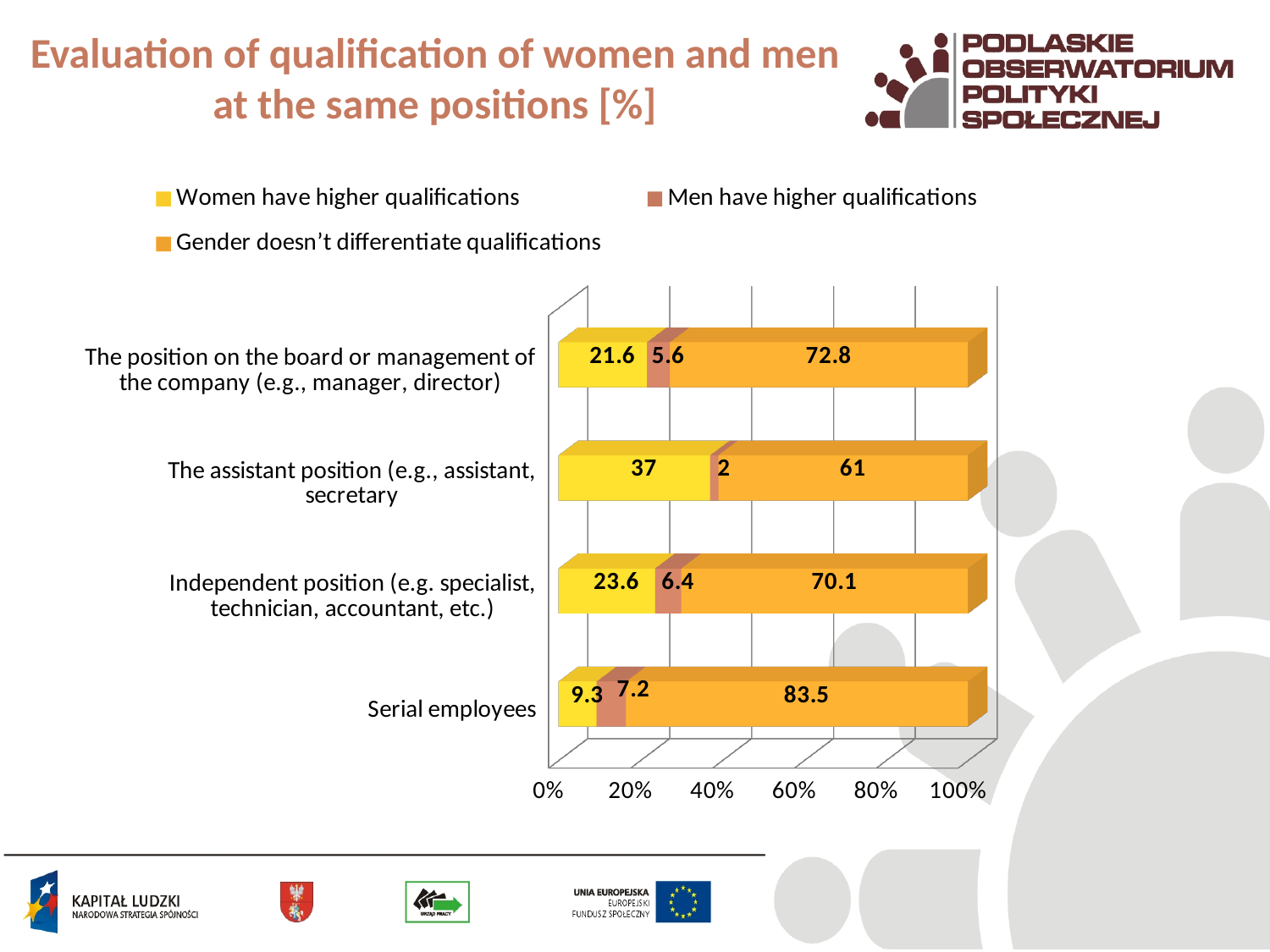
Which position has the highest value for 'Gender doesn't differentiate qualifications'? Serial employees What percentage of respondents said women have higher qualifications for the assistant position? 37 How many positions (categories) are shown in the chart? 4 Which position has the lowest value for 'Men have higher qualifications'? The assistant position (e.g., assistant, secretary) What is the total of the stacked bar for the position on the board or management of the company? 100 What is the value for 'Women have higher qualifications' for the position on the board or management of the company? 21.6 How many series does the legend list? 3 What is the value for 'Gender doesn't differentiate qualifications' for serial employees? 83.5 Which is larger for the independent position: 'Women have higher qualifications' or 'Men have higher qualifications'? Women have higher qualifications What kind of chart is shown on the slide? Stacked bar chart What is the value for 'Men have higher qualifications' for the independent position? 6.4 What is the difference between the 'Women have higher qualifications' values for the assistant position and serial employees? 27.7